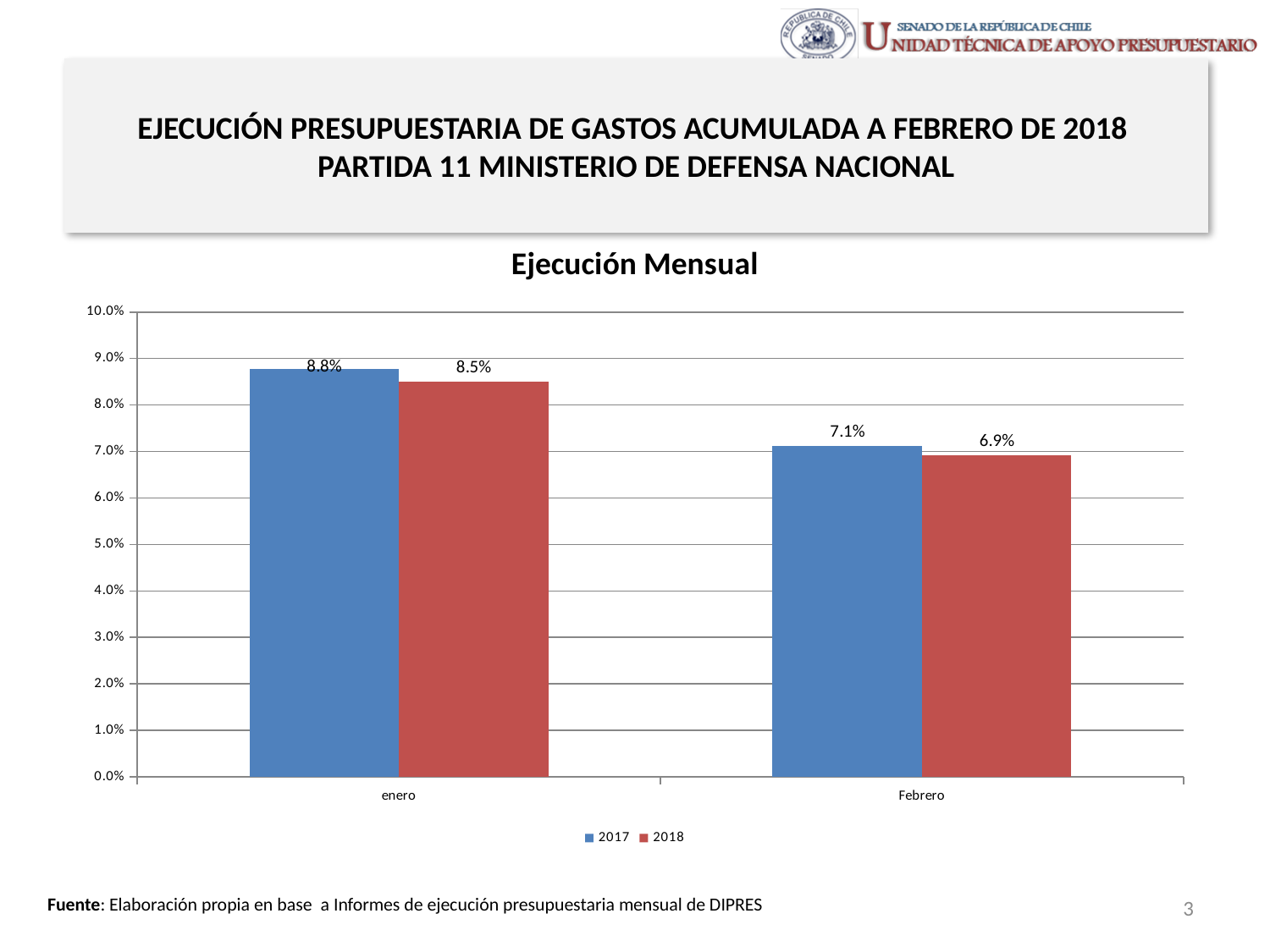
How many months are shown on the x axis? 2 What is the value for 2018 in Febrero? 6.9% Which month has the lowest value for the 2018 series? Febrero Which month has the highest value for the 2017 series? enero What is the value for 2017 in enero? 8.8% What is the difference between the 2017 and 2018 values in enero? 0.3% Which is larger in Febrero, the 2017 value or the 2018 value? 2017 What is the title of the chart? Ejecución Mensual What kind of chart is shown? bar chart How many series does the legend list? 2 What is the value for 2017 in Febrero? 7.1% What is the value for 2018 in enero? 8.5%